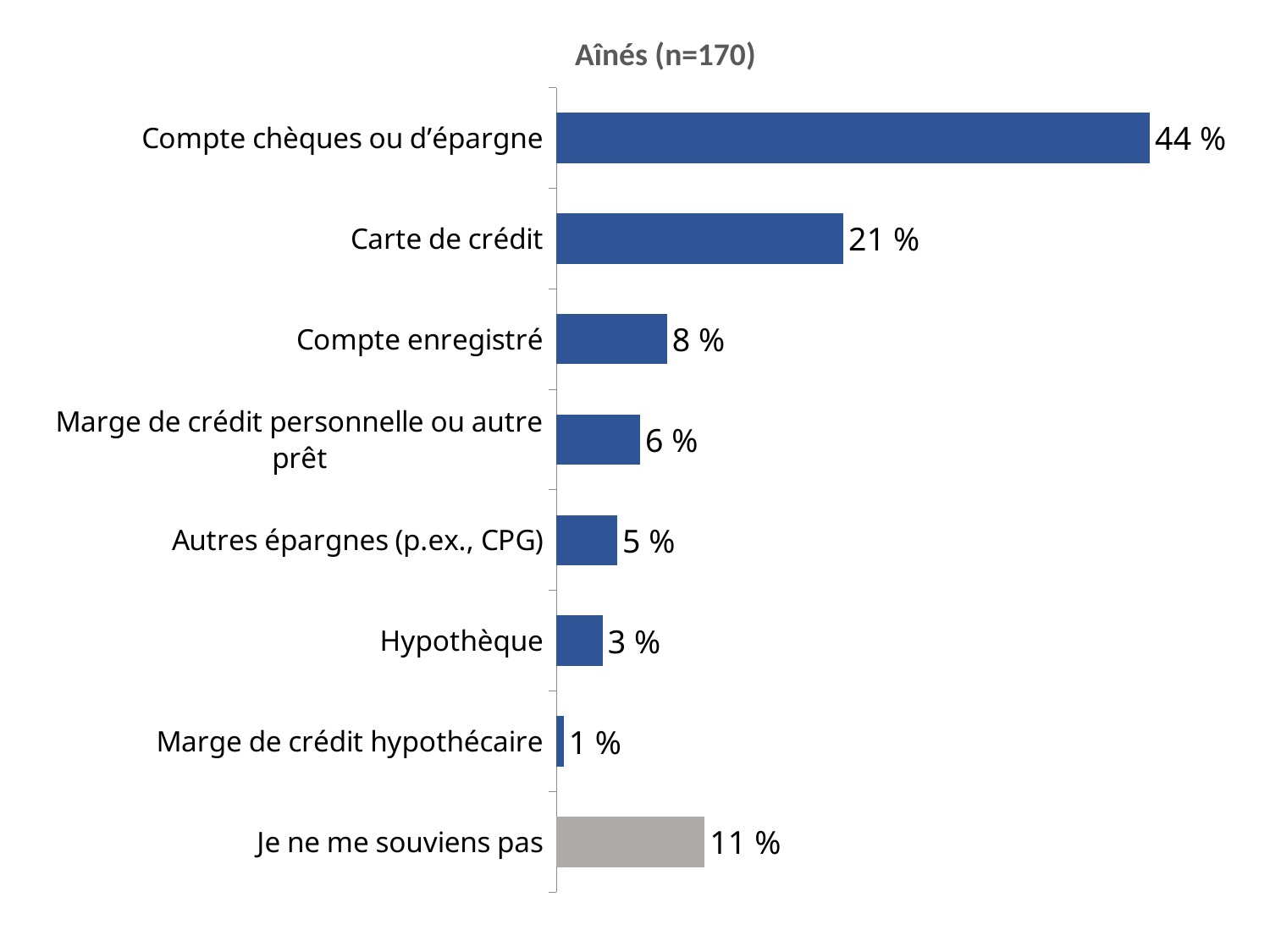
How many categories are shown in the chart? 8 What is the value for Hypothèque? 3 % What is the difference between the values for Compte chèques ou d’épargne and Carte de crédit? 23 % Which category has the lowest value? Marge de crédit hypothécaire Which category's bar is coloured grey rather than blue? Je ne me souviens pas Which category has the highest value? Compte chèques ou d’épargne What is the value for Je ne me souviens pas? 11 % What is the title of the chart? Aînés (n=170) What is the value for Carte de crédit? 21 % What is the value for Compte chèques ou d’épargne? 44 % What kind of chart is this? Bar chart Which is larger, the value for Compte enregistré or the value for Autres épargnes (p.ex., CPG)? Compte enregistré